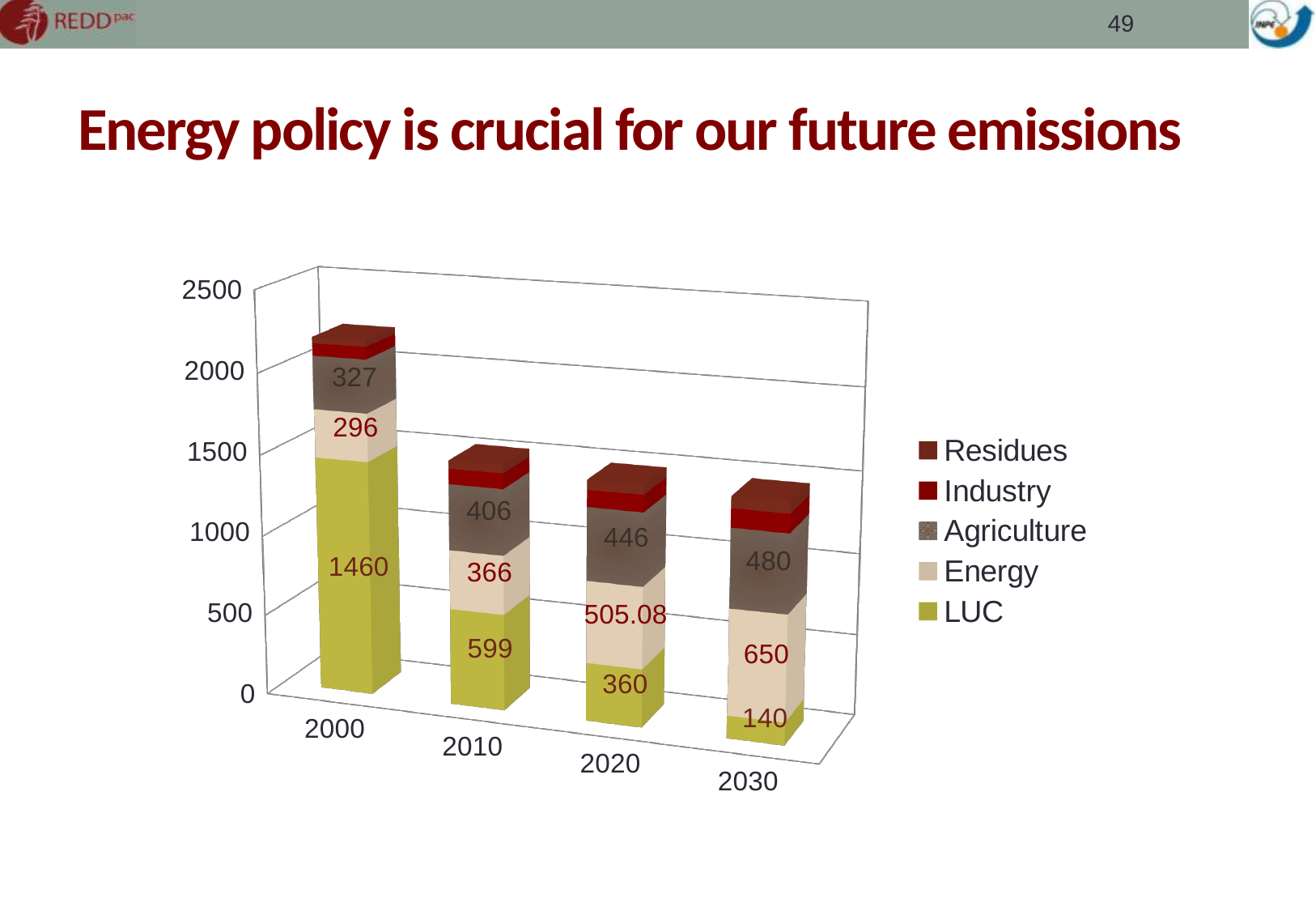
Which year has the lowest Energy value? 2000 Which is larger, the Energy value for 2030 or the Agriculture value for 2030? Energy value for 2030 What is the Energy value for 2020? 505.08 What is the difference between the LUC value in 2000 and the LUC value in 2010? 861 What is the LUC value for 2030? 140 What kind of chart is shown on the slide? Stacked bar chart Do the LUC values rise or fall from 2000 to 2030? Fall How many series does the legend list? 5 What is the Agriculture value for 2030? 480 How many years are shown on the x axis? 4 What is the LUC value for 2000? 1460 Which year has the highest LUC value? 2000